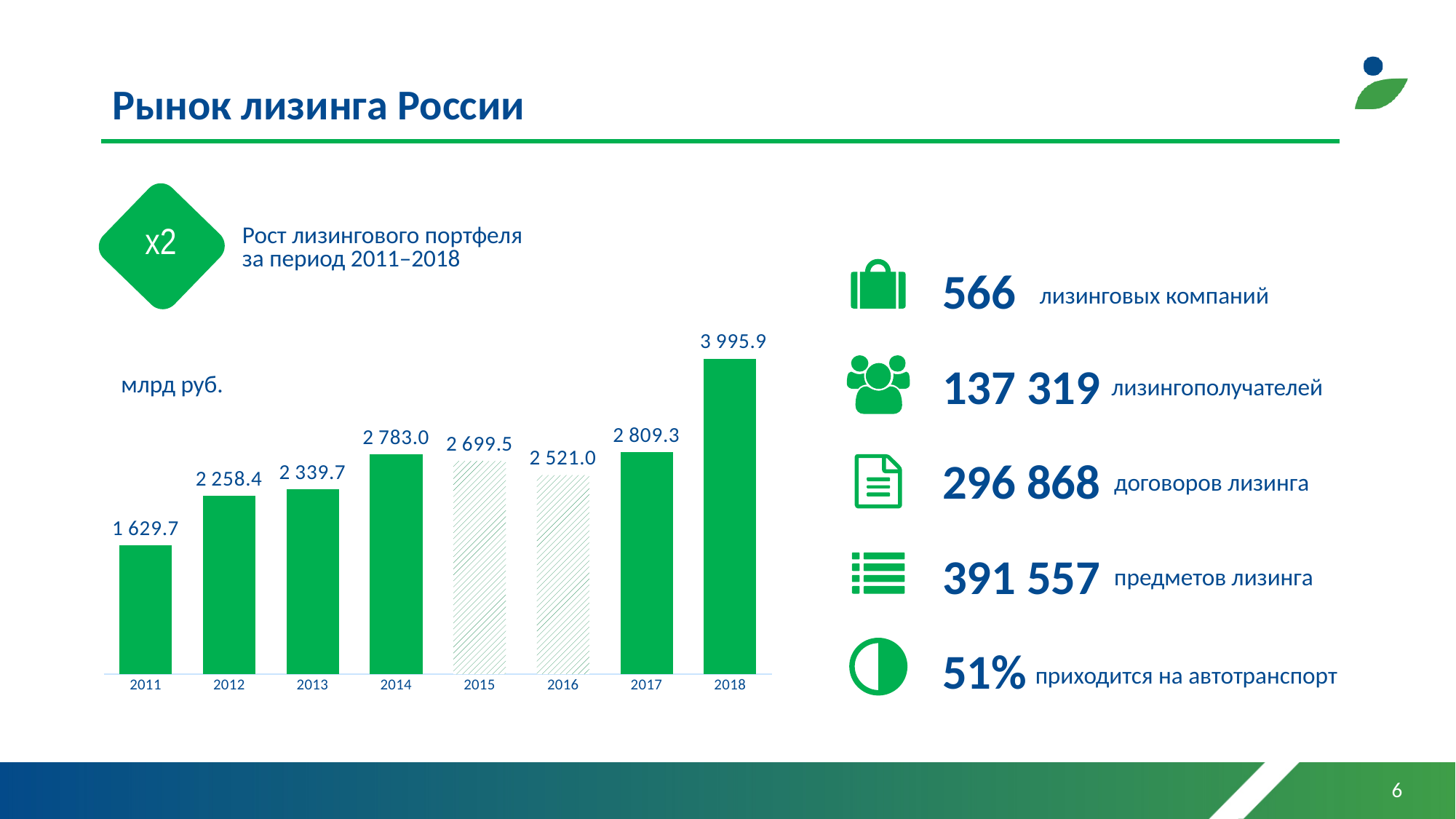
Which year has the lowest value on the bar chart? 2011 What is the value for 2018 on the bar chart? 3 995.9 Which is larger on the bar chart, the value for 2015 or the value for 2016? 2015 What unit is indicated for the values on the bar chart? млрд руб. What kind of chart is shown on the slide? bar chart What is the value for 2015 on the bar chart? 2 699.5 Which year has the highest value on the bar chart? 2018 How many years are shown on the bar chart? 8 What is the difference between the values for 2014 and 2013 on the bar chart? 443.3 What is the difference between the values for 2018 and 2011 on the bar chart? 2 366.2 What is the value for 2011 on the bar chart? 1 629.7 Do the values on the bar chart rise or fall from 2014 to 2016? fall